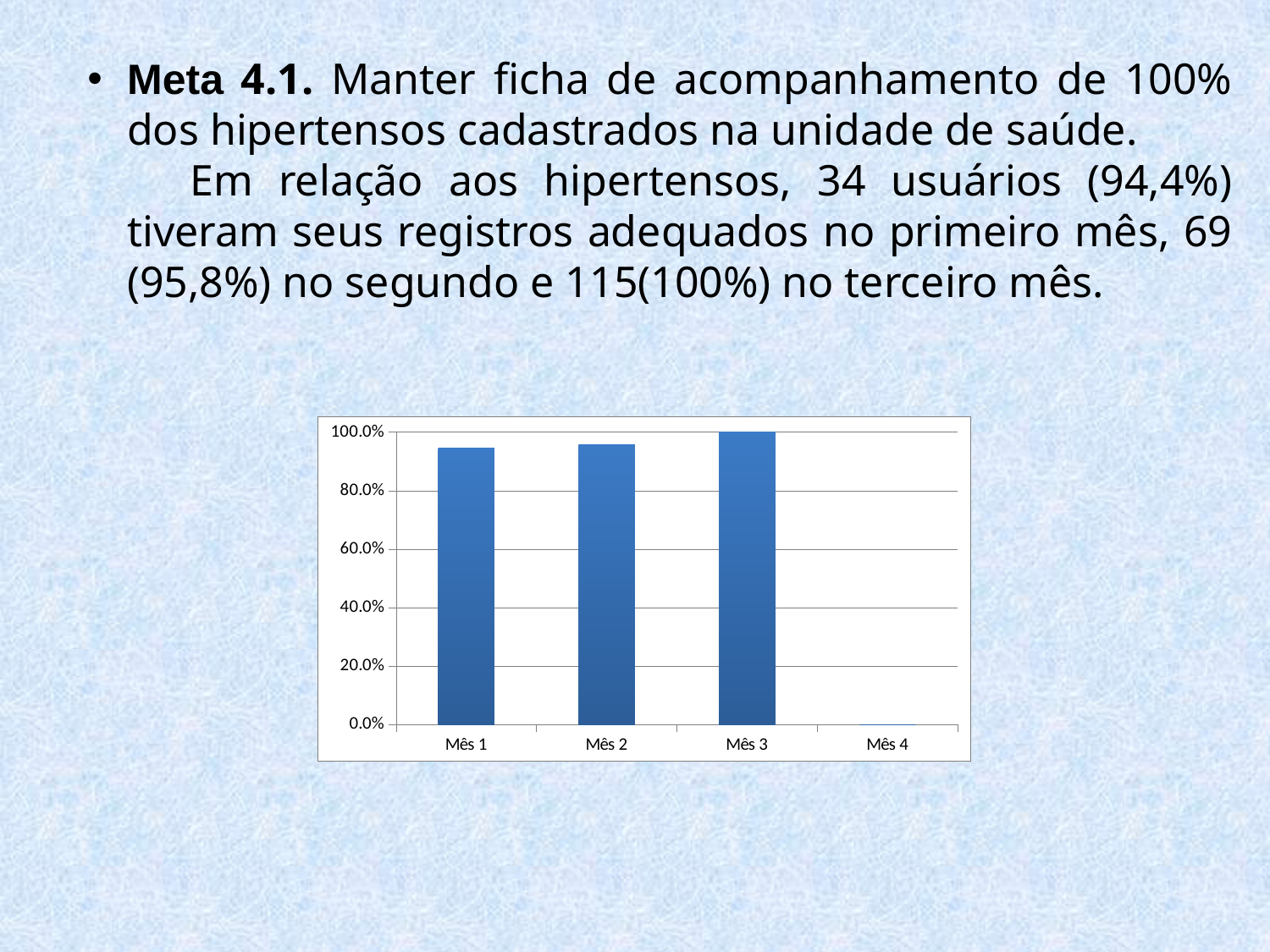
Is the value for Mês 1 greater or less than 80.0%? greater How many categories are shown on the x axis of the chart? 4 What is the highest tick label on the vertical axis of the chart? 100.0% Which month has the highest value in the chart? Mês 3 What kind of chart is shown on the slide? bar chart Which month has the lowest value in the chart? Mês 4 Which is larger, the value for Mês 3 or the value for Mês 4? Mês 3 Is the value for Mês 2 greater or less than 80.0%? greater Do the values rise or fall from Mês 1 to Mês 3? rise What is the value for Mês 3 in the chart? 100.0% Is the value for Mês 1 greater or less than 100.0%? less